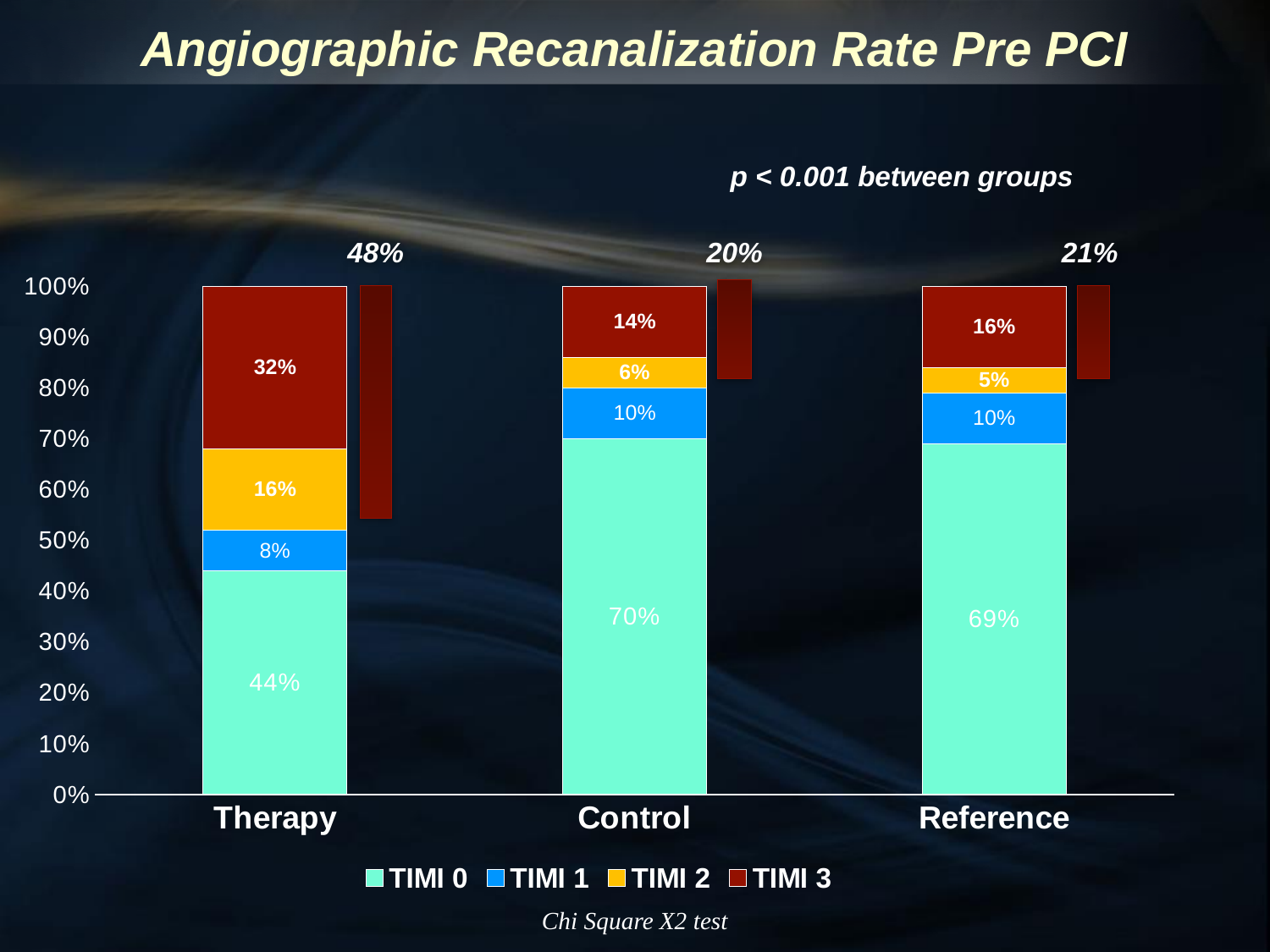
What is the TIMI 1 value for the Therapy group? 8% What is the title of the chart? Angiographic Recanalization Rate Pre PCI What is the TIMI 0 value for the Therapy group? 44% How many groups are shown on the x axis? 3 Which group has the lowest TIMI 0 value? Therapy What kind of chart is shown on the slide? Stacked bar chart What is the difference between the TIMI 3 values for Therapy and Control? 18% Which group has the highest TIMI 3 value? Therapy What is the TIMI 3 value for the Control group? 14% What is the TIMI 2 value for the Reference group? 5% How many series does the legend list? 4 Which is larger, the TIMI 0 value for Control or for Reference? Control